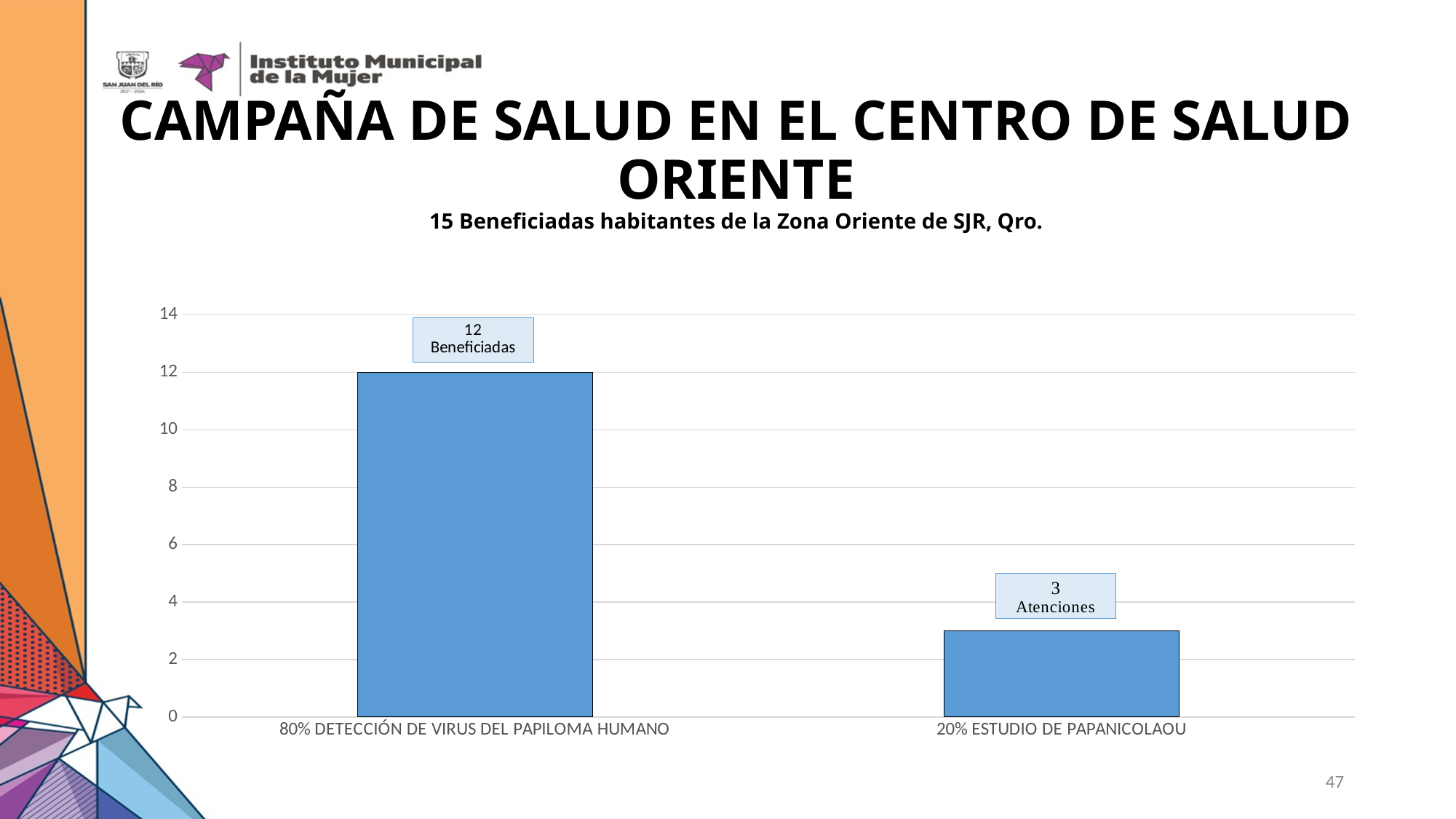
What is the difference between the values for 80% DETECCIÓN DE VIRUS DEL PAPILOMA HUMANO and 20% ESTUDIO DE PAPANICOLAOU? 9 Which category has the lowest value? 20% ESTUDIO DE PAPANICOLAOU What is the highest value shown on the y axis? 14 What is the value for 20% ESTUDIO DE PAPANICOLAOU? 3 What is the text of the data label above the bar for 20% ESTUDIO DE PAPANICOLAOU? 3 Atenciones What kind of chart is shown on the slide? bar chart Is the value for 80% DETECCIÓN DE VIRUS DEL PAPILOMA HUMANO greater or less than 10? greater Which is larger, the value for 80% DETECCIÓN DE VIRUS DEL PAPILOMA HUMANO or the value for 20% ESTUDIO DE PAPANICOLAOU? 80% DETECCIÓN DE VIRUS DEL PAPILOMA HUMANO What is the value for 80% DETECCIÓN DE VIRUS DEL PAPILOMA HUMANO? 12 Which category has the highest value? 80% DETECCIÓN DE VIRUS DEL PAPILOMA HUMANO Is the value for 20% ESTUDIO DE PAPANICOLAOU greater or less than 4? less How many categories are shown on the x axis? 2